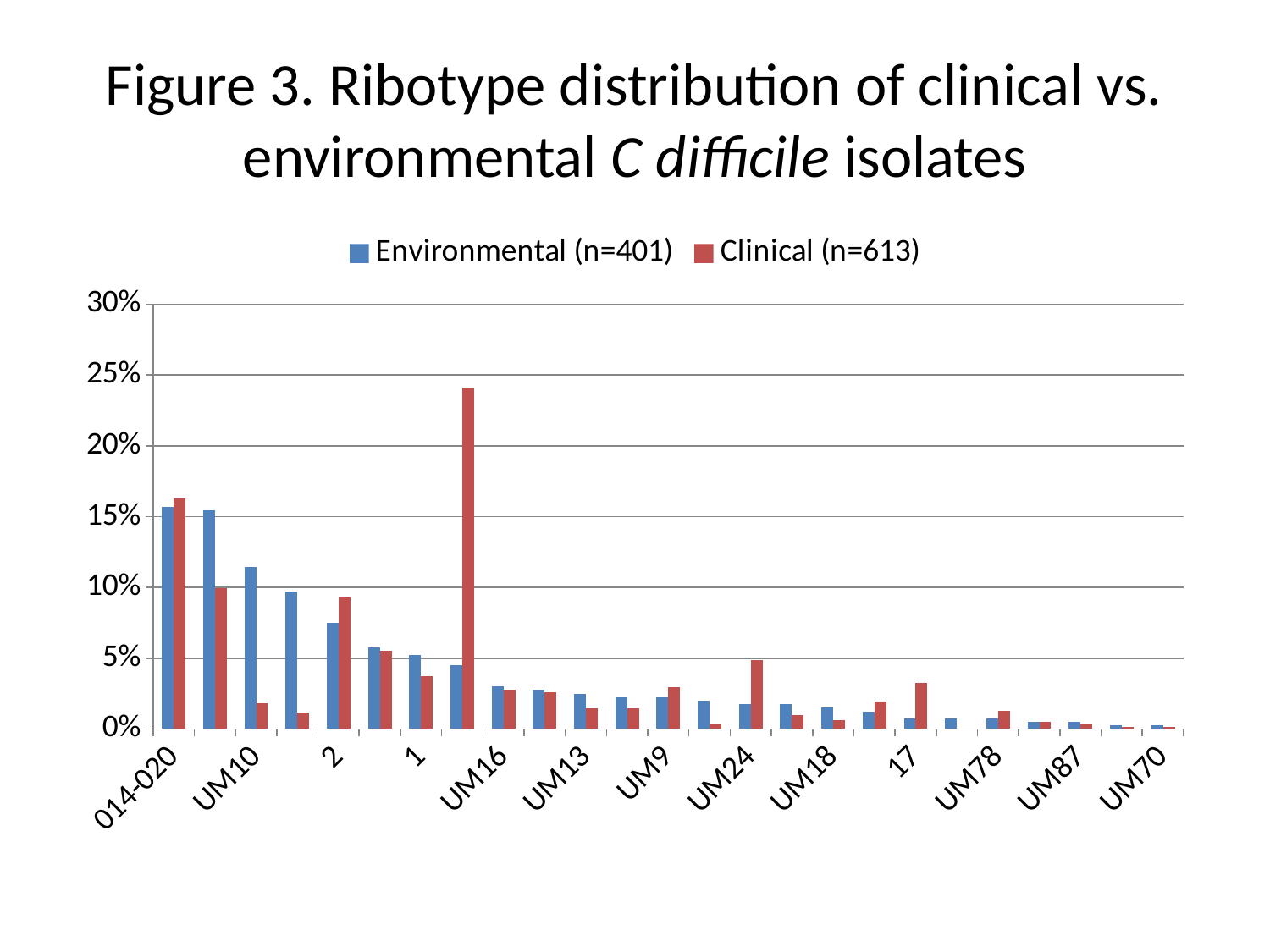
Which series has the larger value for ribotype 17, Environmental (n=401) or Clinical (n=613)? Clinical (n=613) Which series has the larger value for ribotype 2, Environmental (n=401) or Clinical (n=613)? Clinical (n=613) How many ribotype categories are plotted along the x axis? 25 Is the Clinical (n=613) value for ribotype 2 greater or less than 10%? less Which series has the larger value for UM10, Environmental (n=401) or Clinical (n=613)? Environmental (n=401) What kind of chart is shown on the slide? bar chart What are the two series named in the legend? Environmental (n=401) and Clinical (n=613) Is the Environmental (n=401) value for UM10 greater or less than 10%? greater Do the Environmental (n=401) values generally rise or fall from left to right along the x axis? fall Is the Clinical (n=613) value for UM10 greater or less than 5%? less How many series does the legend list? 2